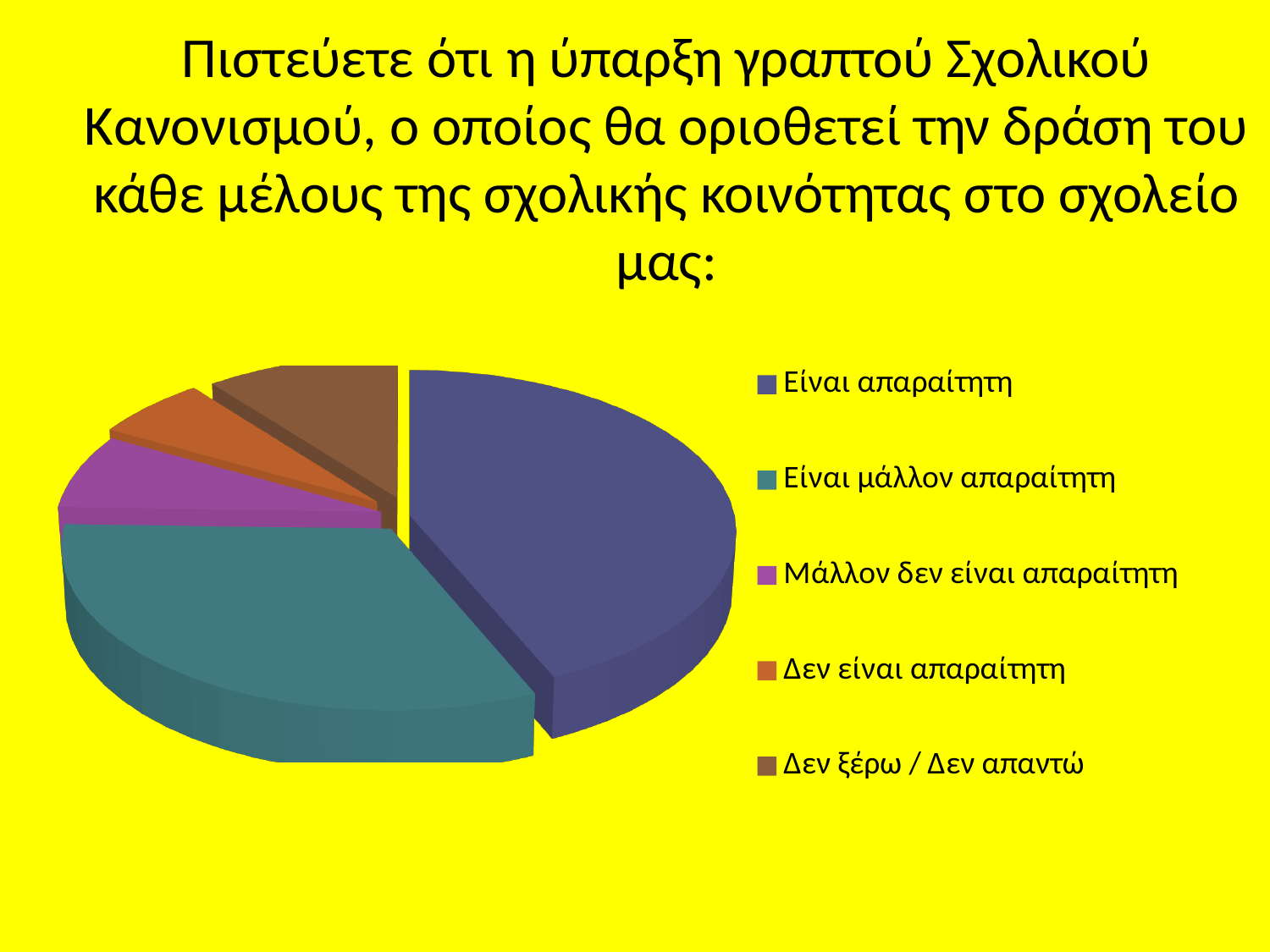
How many slices does the pie chart have? 5 Which legend entry is listed first in the legend? Είναι απαραίτητη How many entries does the legend list? 5 Which legend entry is shown in brown? Δεν ξέρω / Δεν απαντώ Which is larger, the slice for "Είναι μάλλον απαραίτητη" or the slice for "Μάλλον δεν είναι απαραίτητη"? Είναι μάλλον απαραίτητη What kind of chart is shown on the slide? Pie chart Which is larger, the slice for "Είναι απαραίτητη" or the slice for "Μάλλον δεν είναι απαραίτητη"? Είναι απαραίτητη Which is larger, the slice for "Είναι μάλλον απαραίτητη" or the slice for "Δεν είναι απαραίτητη"? Είναι μάλλον απαραίτητη